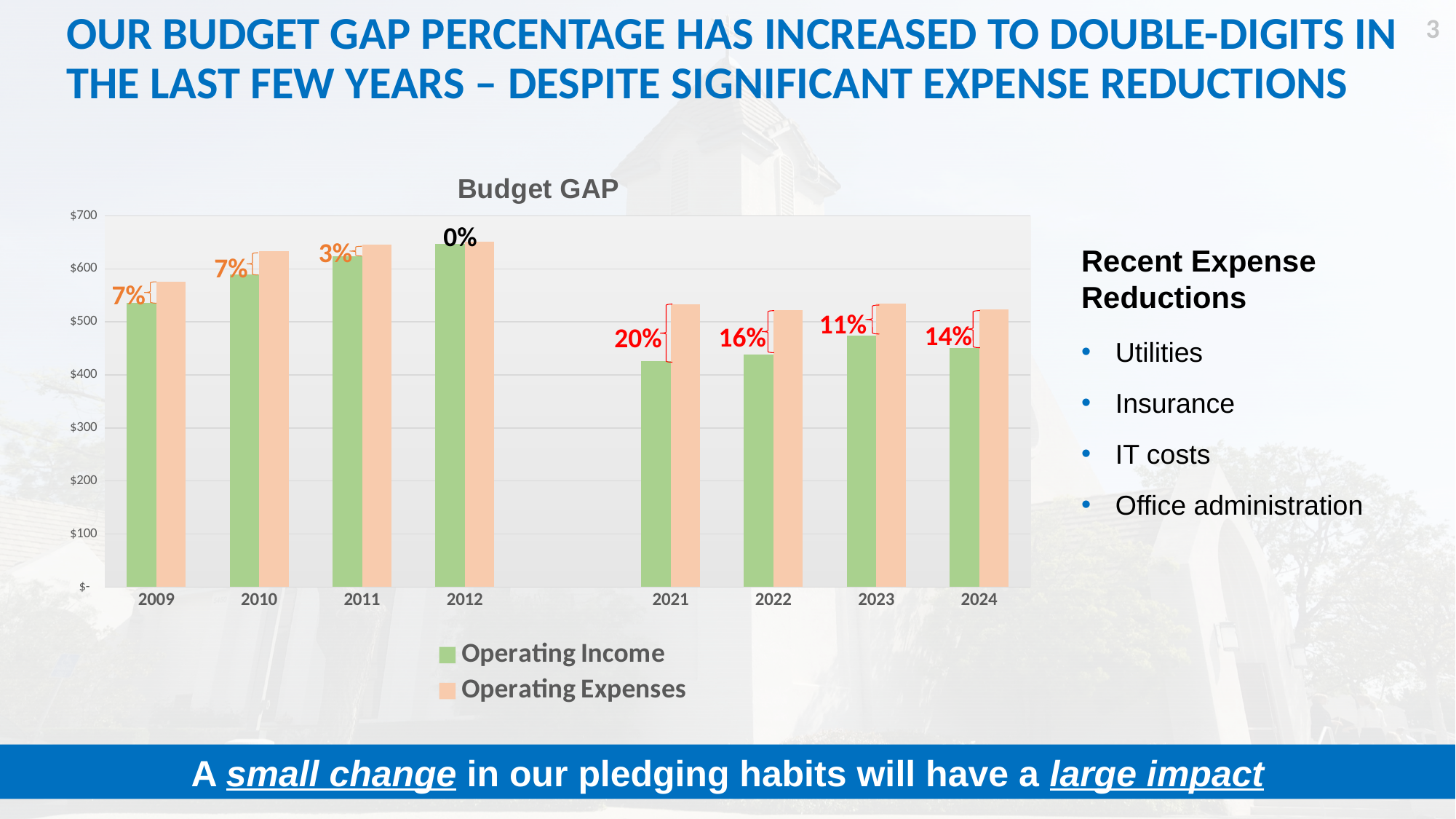
What budget gap percentage is labelled for 2021 in the Budget GAP chart? 20% How many years are shown on the x axis of the Budget GAP chart? 8 Which year has the highest labelled budget gap percentage in the Budget GAP chart? 2021 What type of chart is the Budget GAP chart? bar chart How many series does the legend of the Budget GAP chart list? 2 In the Budget GAP chart, how many percentage points higher is the labelled gap for 2021 than for 2024? 6 percentage points What budget gap percentage is labelled for 2012 in the Budget GAP chart? 0% What budget gap percentage is labelled for 2023 in the Budget GAP chart? 11% In the Budget GAP chart, which is larger in 2021: Operating Income or Operating Expenses? Operating Expenses In the Budget GAP chart, does Operating Income rise or fall from 2009 to 2012? rise In the Budget GAP chart, is the Operating Income value for 2021 greater or less than $500? less Which year has the lowest labelled budget gap percentage in the Budget GAP chart? 2012